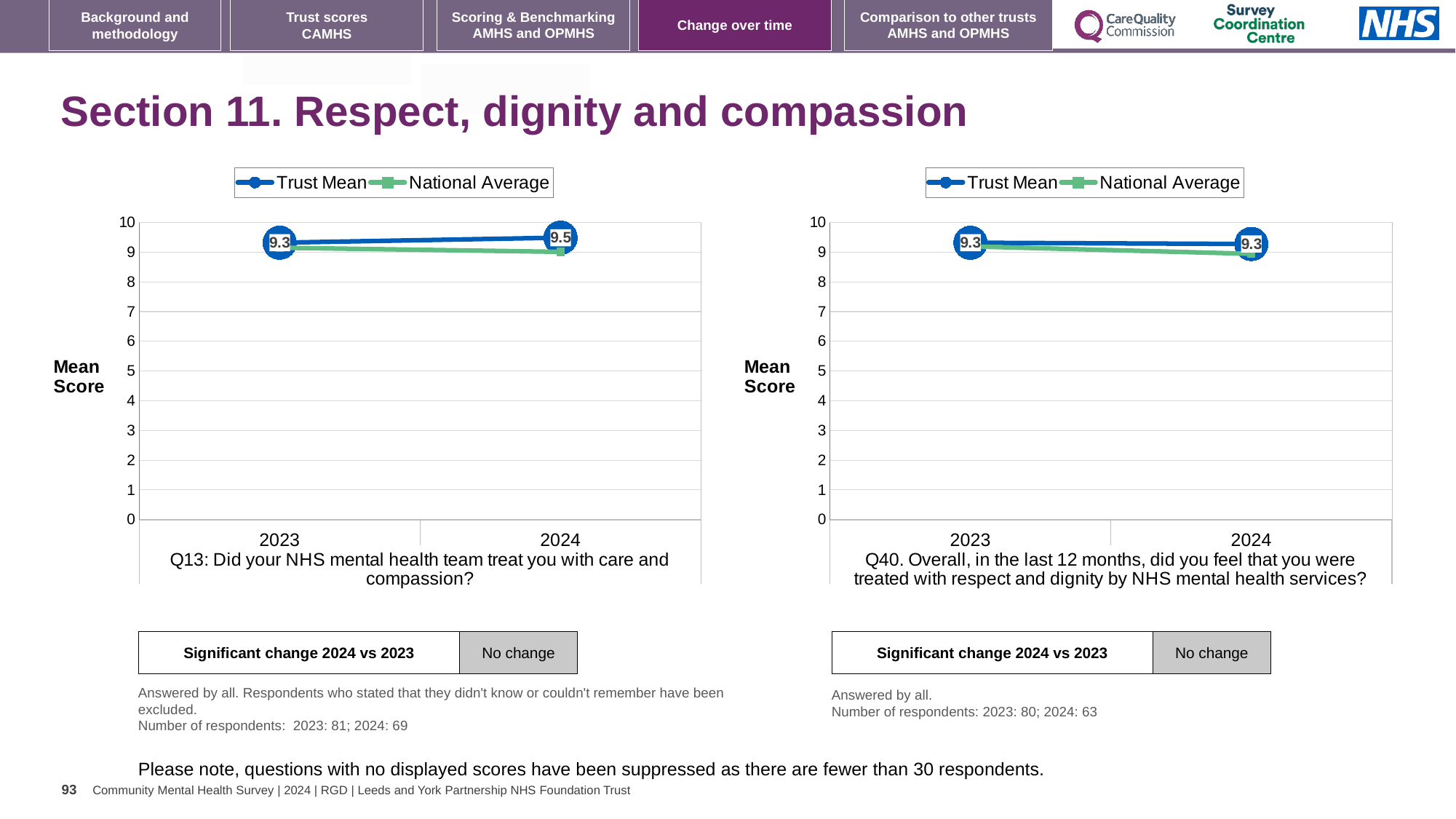
How many series does the legend of the Q13 chart on the left list? 2 In the Q13 chart on the left, what is the Trust Mean score for 2024? 9.5 In the Q13 chart on the left, by how much did the Trust Mean change from 2023 to 2024? 0.2 In the Q40 chart on the right, what is the Trust Mean score for 2024? 9.3 What type of chart is used for Q40 on the right? line chart What are the two series named in the legend of the Q40 chart on the right? Trust Mean and National Average In the Q40 chart on the right, does the Trust Mean rise, fall or stay the same from 2023 to 2024? stays the same How many years are shown on the x axis of the Q40 chart on the right? 2 In the Q13 chart on the left, is the Trust Mean higher in 2023 or 2024? 2024 In the Q40 chart on the right, is the National Average for 2024 greater or less than 8? greater In the Q13 chart on the left, does the Trust Mean rise or fall from 2023 to 2024? rise In the Q13 chart on the left, what is the Trust Mean score for 2023? 9.3